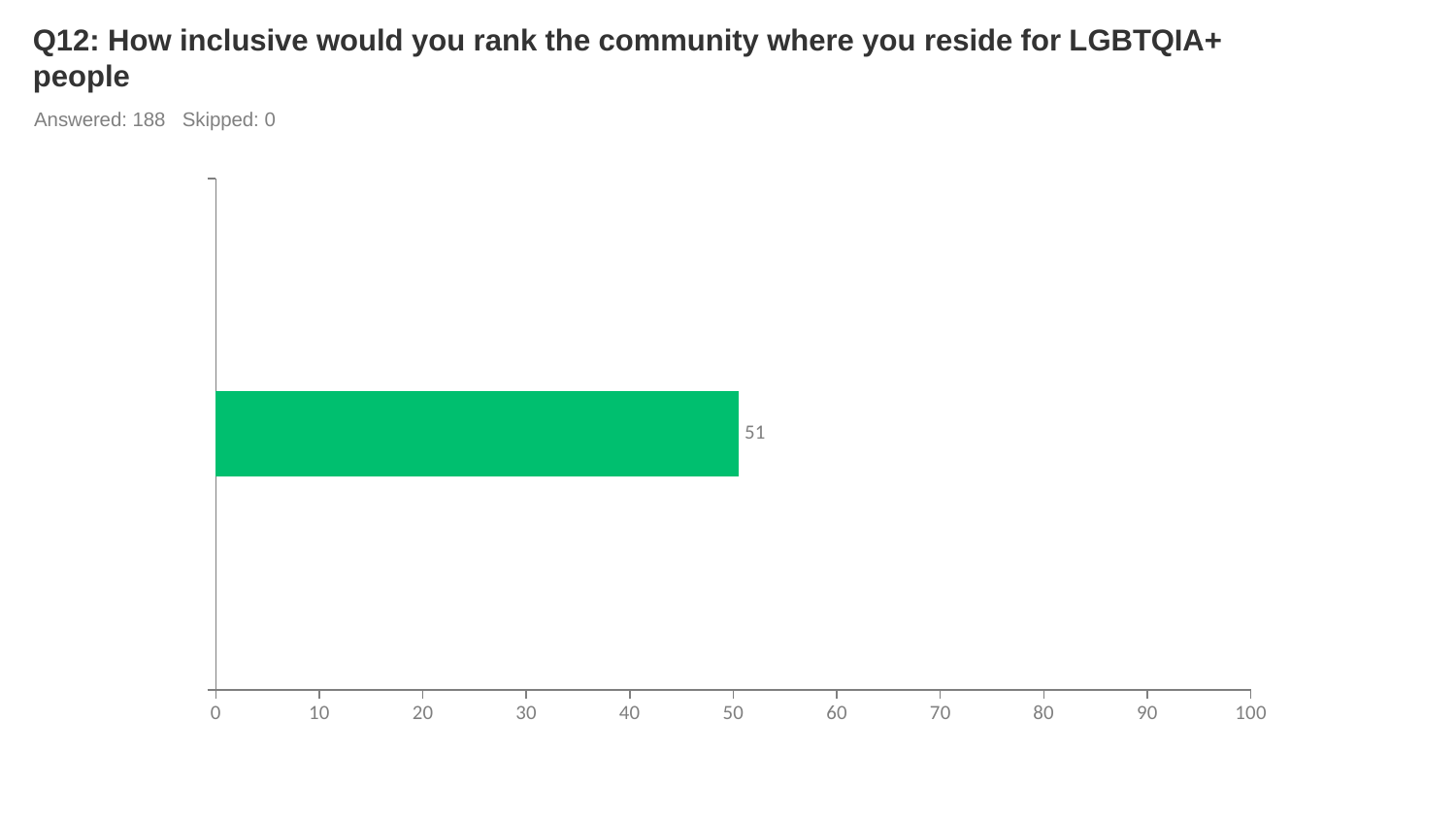
Is the value of the bar greater or less than 60? less What kind of chart is shown on the slide? bar chart How many bars are plotted in the chart? 1 What colour is the bar in the chart? green Is the value of the bar greater or less than 40? greater What is the highest value shown on the x axis? 100 What value is shown by the data label on the bar? 51